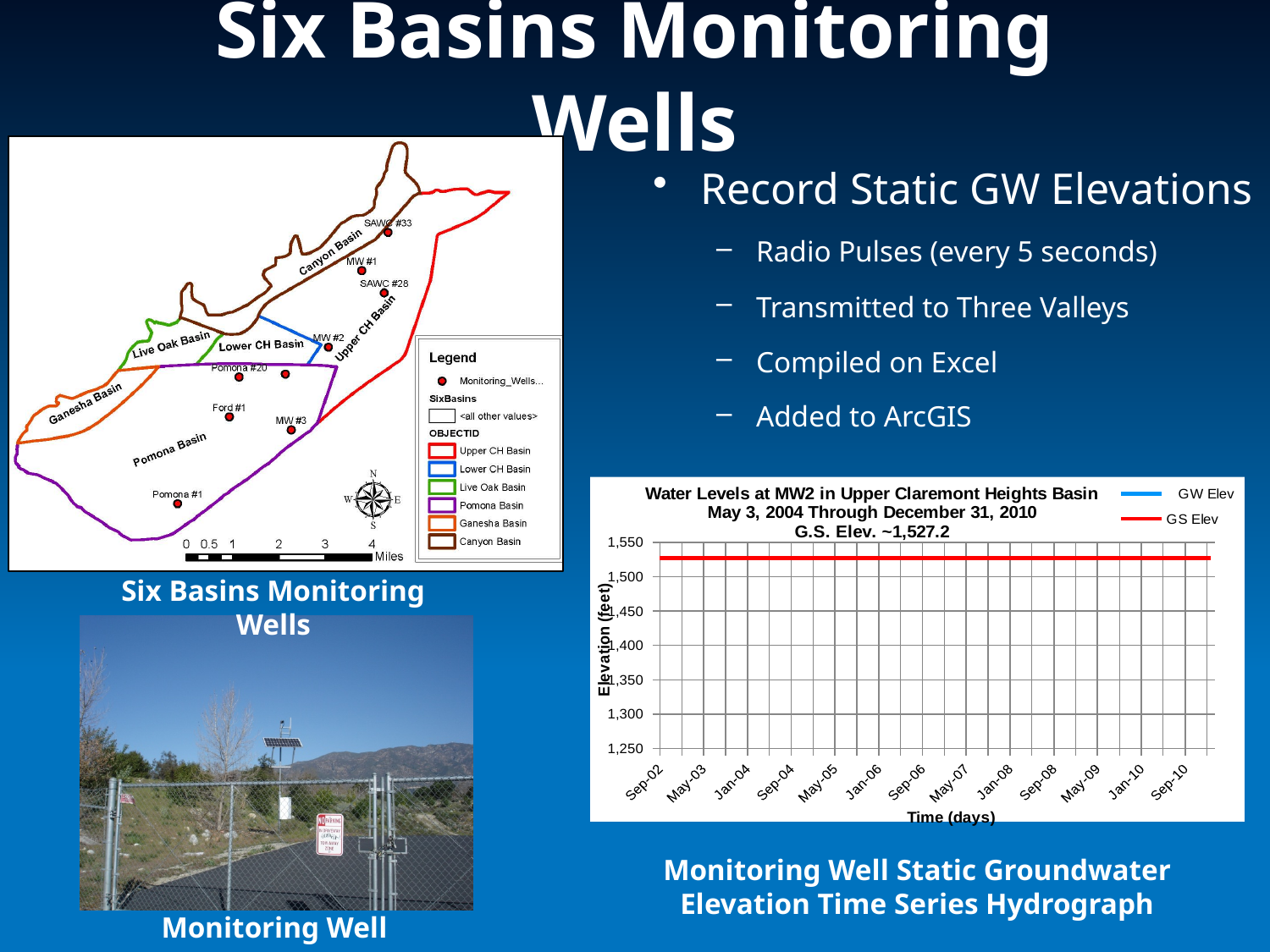
In the 'Water Levels at MW2' chart, is the GS Elev line greater or less than 1,550 feet? less What kind of chart is the 'Water Levels at MW2 in Upper Claremont Heights Basin' chart? line chart In the 'Water Levels at MW2' chart, is the GS Elev line greater or less than 1,500 feet? greater What colour is the GS Elev line in the 'Water Levels at MW2' chart? red What are the two legend entries in the 'Water Levels at MW2' chart? GW Elev and GS Elev In the 'Water Levels at MW2' chart, does the GS Elev line rise, fall, or stay flat from Sep-02 to Sep-10? stays flat How many series does the legend of the 'Water Levels at MW2' chart list? 2